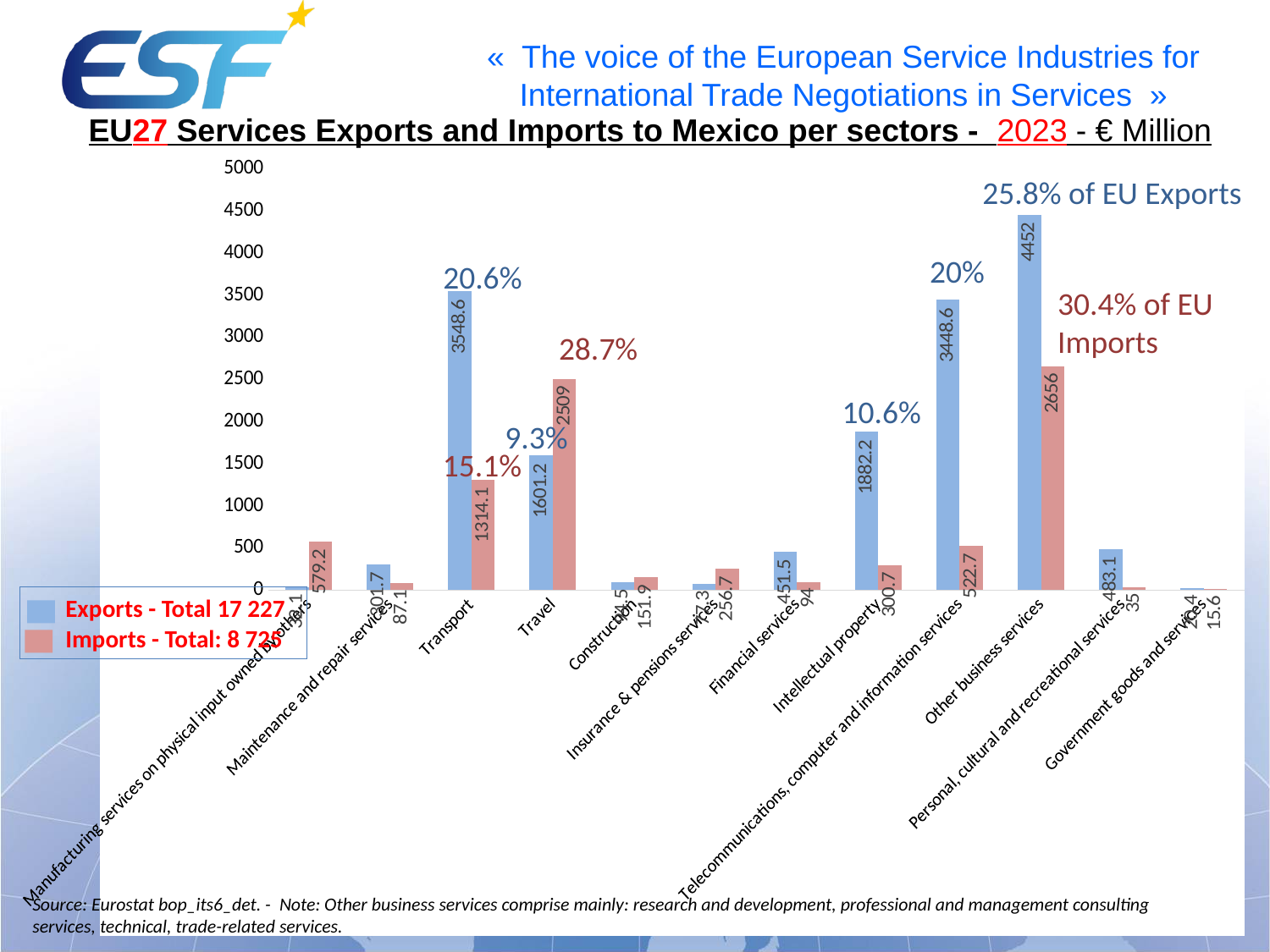
Which sector has the highest Imports value? Other business services What share of EU Exports does Other business services represent, according to the annotation on the chart? 25.8% For Travel, which is larger: Exports or Imports? Imports What kind of chart is shown on the slide? bar chart What is the value of Exports for Transport? 3548.6 What is the difference between Exports and Imports for Other business services? 1796 How many series does the legend list? 2 Which sector has the highest Exports value? Other business services What is the value of Exports for Telecommunications, computer and information services? 3448.6 What is the value of Imports for Intellectual property? 300.7 How many sectors are shown on the x axis? 12 What is the value of Imports for Travel? 2509